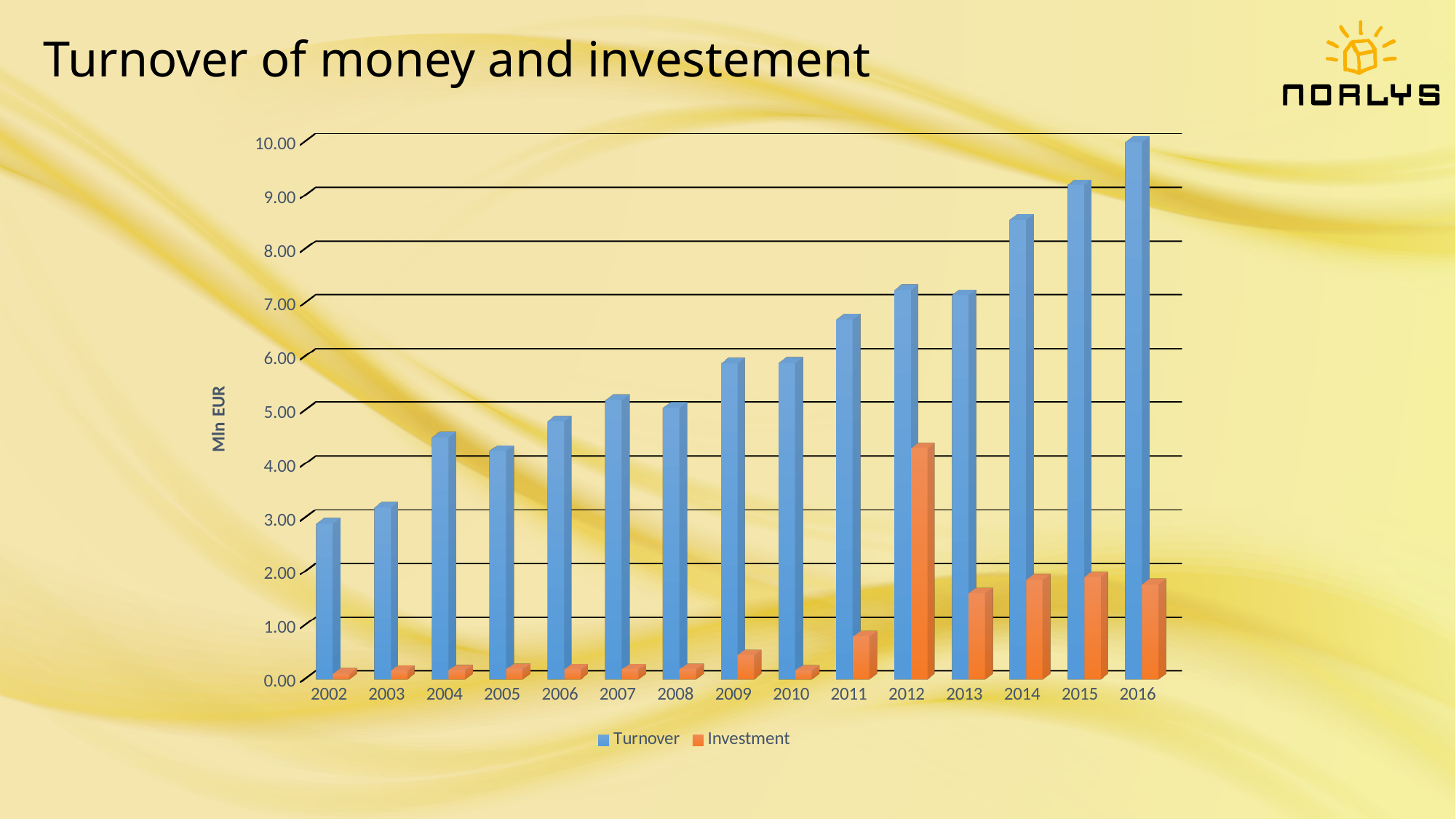
Is the Turnover value for 2016 greater or less than 9.00? greater Which is larger, Turnover in 2003 or Turnover in 2006? 2006 What is the label on the vertical axis of the chart? Mln EUR Does Turnover generally rise or fall from 2002 to 2016? Rise How many years are shown on the x axis of the chart? 15 What kind of chart is shown on the slide? Bar chart In which year is Turnover highest? 2016 In which year is Investment highest? 2012 Is the Turnover value for 2005 greater or less than 5.00? less How many series does the chart's legend list? 2 Is the Investment value for 2013 greater or less than 2.00? less In which year is Turnover lowest? 2002